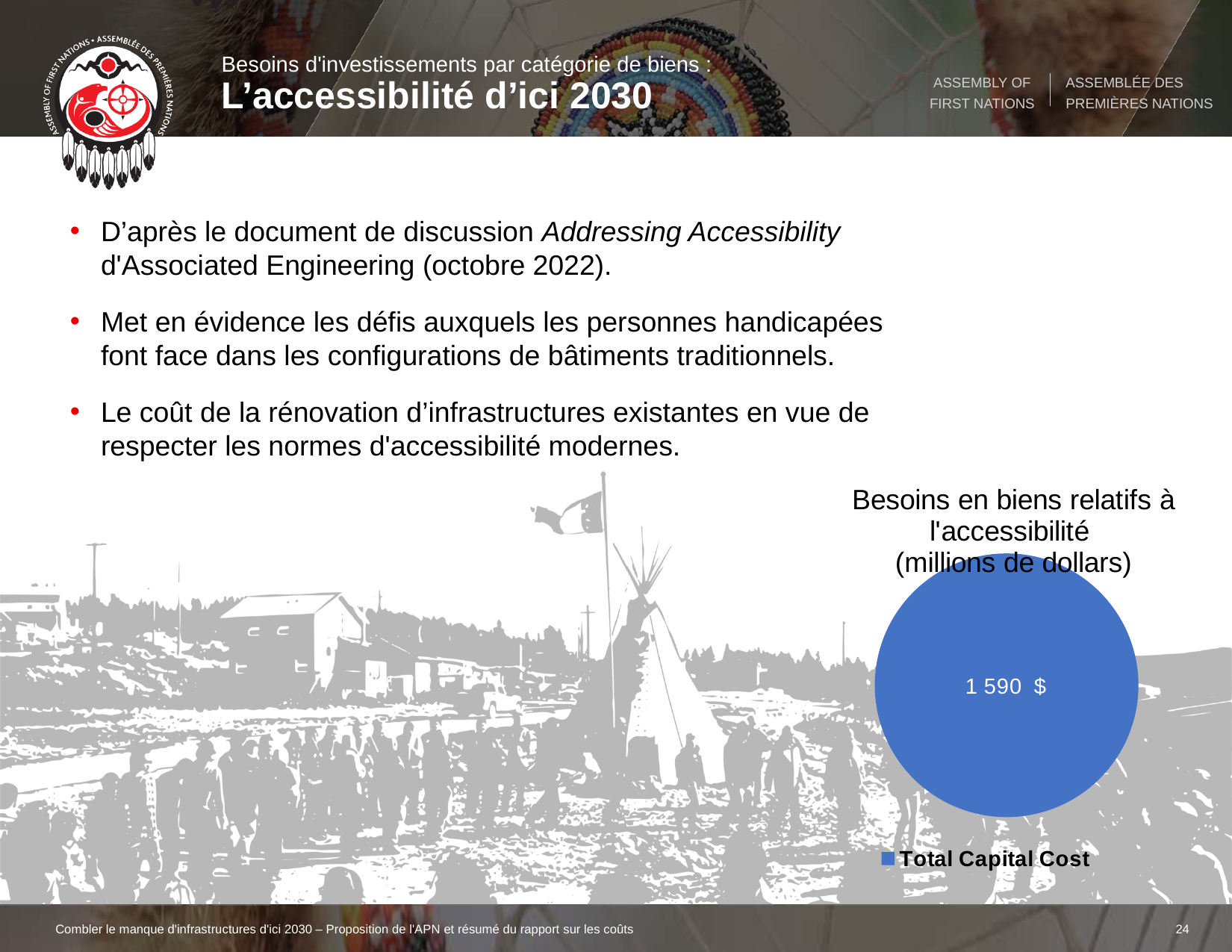
How many entries does the chart legend list? 1 What is the legend entry shown below the pie chart? Total Capital Cost What is the title of the pie chart? Besoins en biens relatifs à l'accessibilité (millions de dollars) What share of the pie does the Total Capital Cost slice represent? 100% What kind of chart is shown on the slide? pie chart How many slices does the pie chart have? 1 What value is shown on the pie chart for Total Capital Cost? 1 590 $ In what unit are the values of the pie chart expressed, according to its title? millions de dollars